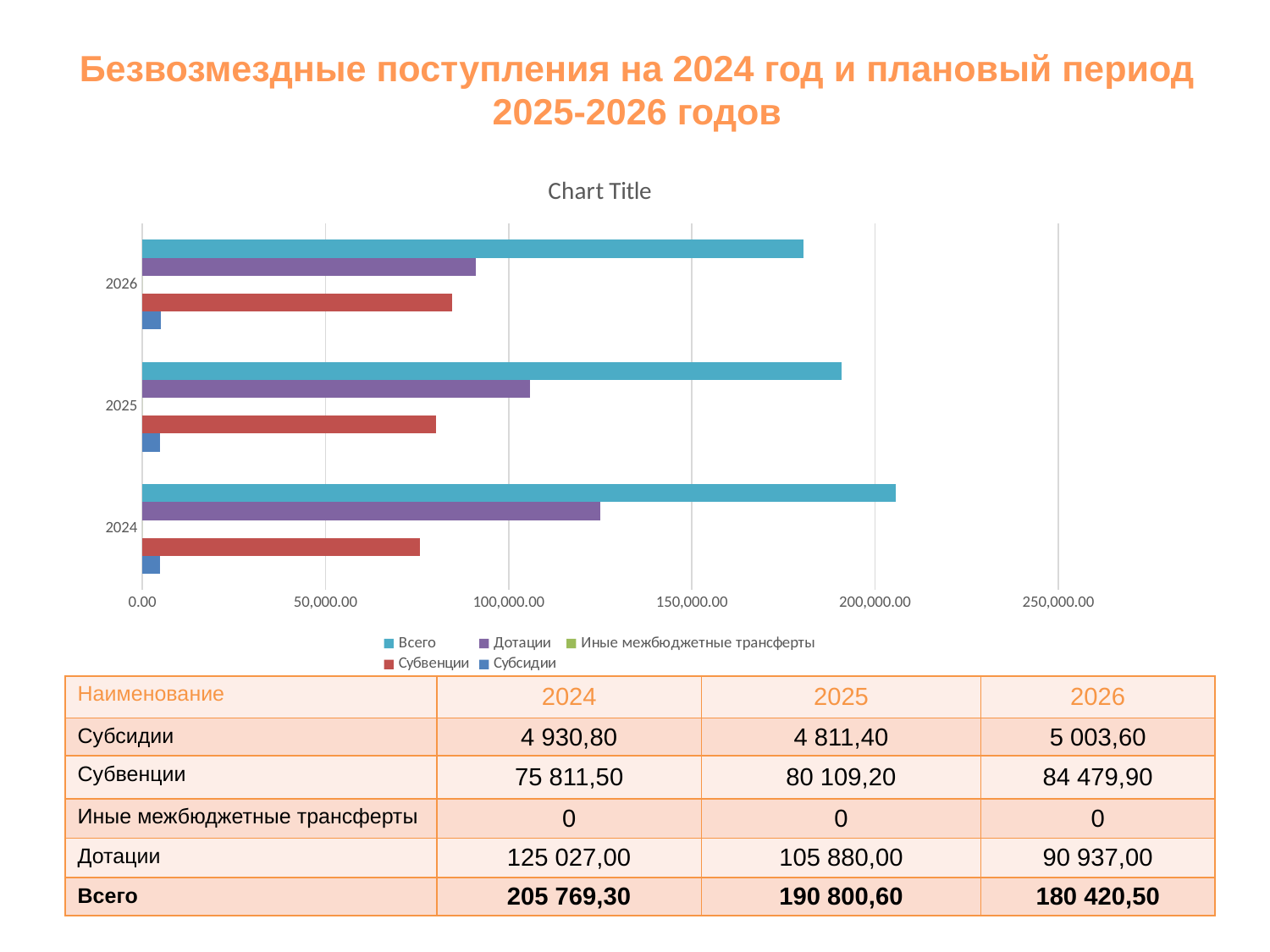
Which year has the highest value for Всего? 2024 What kind of chart is shown on the slide? bar chart Does the value of Всего rise or fall from 2024 to 2026? fall What is the value of Всего for 2024? 205 769,30 In 2024, which is larger: Дотации or Субвенции? Дотации What is the value of Субвенции for 2026? 84 479,90 Is the value of Всего for 2025 greater or less than 150,000.00? greater How many series does the chart legend list? 5 What title is displayed above the chart? Chart Title How many years (categories) are plotted on the chart? 3 Which year has the lowest value for Субвенции? 2024 What is the difference between Всего for 2024 and Всего for 2026? 25 348,80